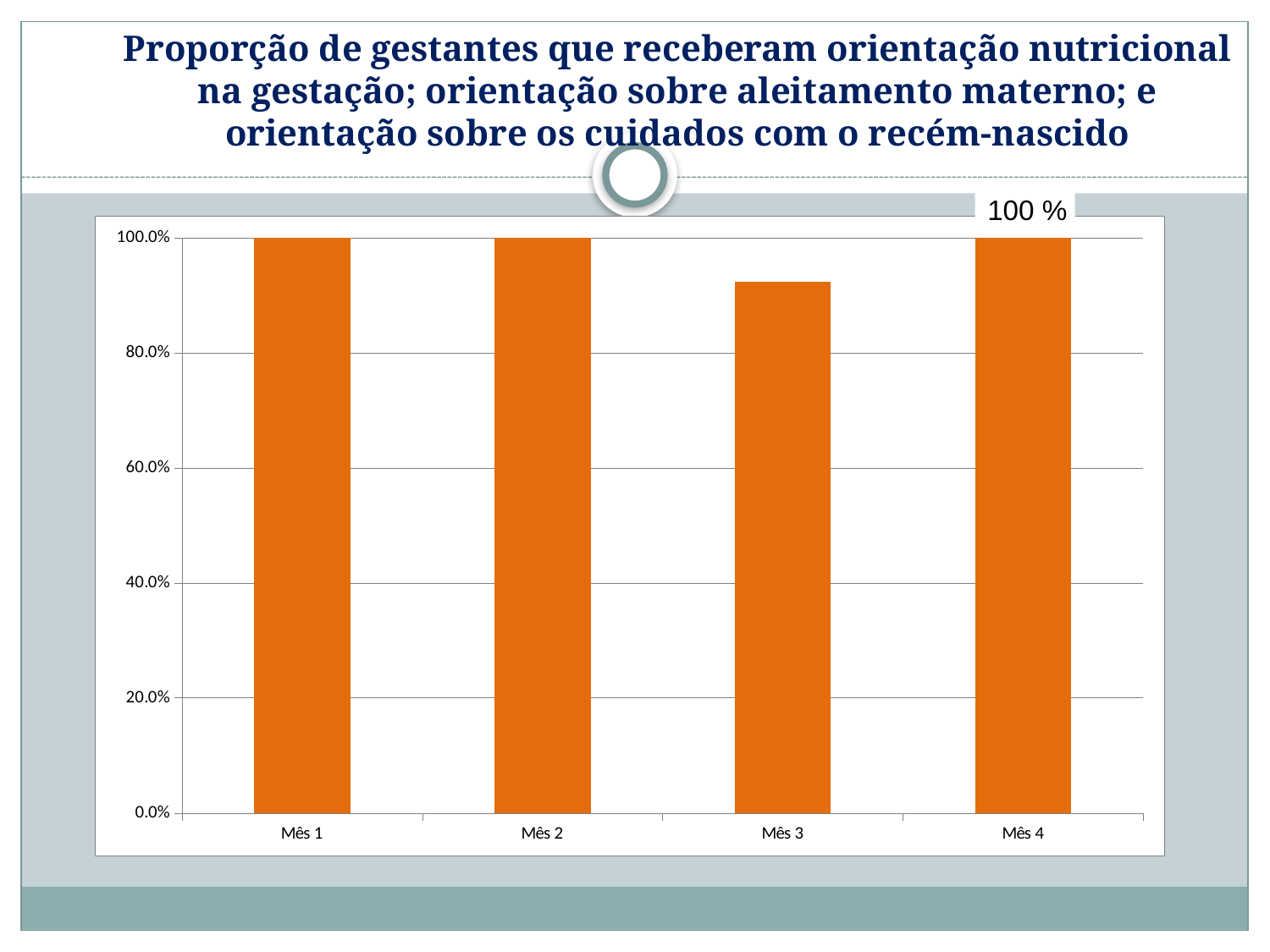
Is the value for Mês 3 greater or less than 80.0%? greater Which is larger, the value for Mês 2 or the value for Mês 3? Mês 2 Does the value rise or fall from Mês 2 to Mês 3? fall What is the label of the first category on the x axis? Mês 1 Is the value for Mês 3 greater or less than 100.0%? less What is the value for Mês 4? 100.0% What is the value for Mês 1? 100.0% Does the value rise or fall from Mês 3 to Mês 4? rise What colour are the bars in the chart? orange Which month has the lowest value? Mês 3 What type of chart is shown on the slide? bar chart How many categories (months) are shown on the x axis? 4